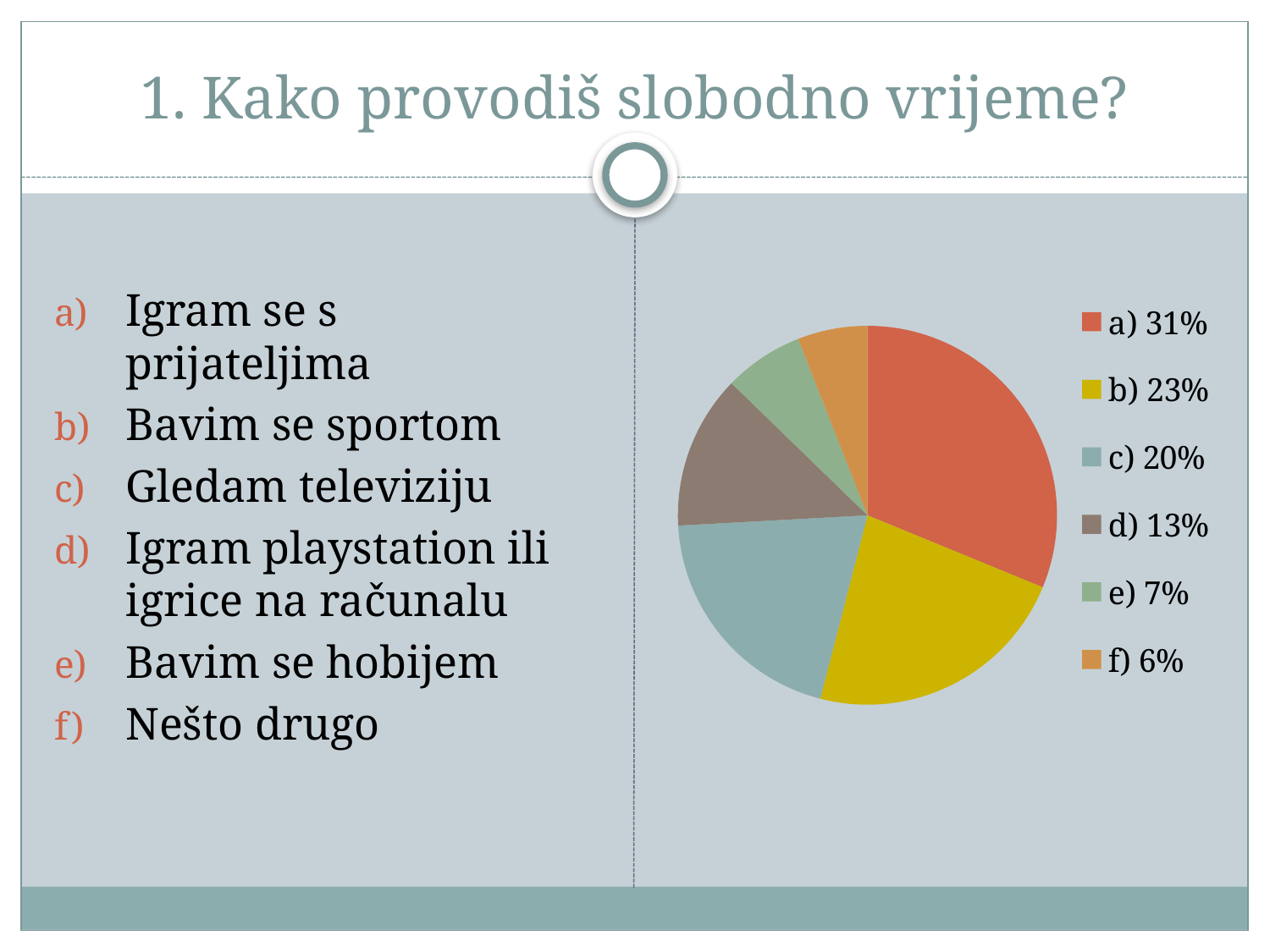
How many slices does the pie chart have? 6 What colour is the slice for a) in the pie chart? red What is the combined share of slices e) and f)? 13% Which slice has the largest share of the pie? a) 31% What kind of chart is shown on the slide? pie chart What percentage is shown for slice a) in the legend? 31% What percentage is shown for slice e) in the legend? 7% Which is larger, slice b) or slice c)? b) Which slice has the smallest share of the pie? f) 6% What is the difference in percentage points between slice a) and slice b)? 8 What percentage is shown for slice c) in the legend? 20% What is the difference in percentage points between slice c) and slice d)? 7